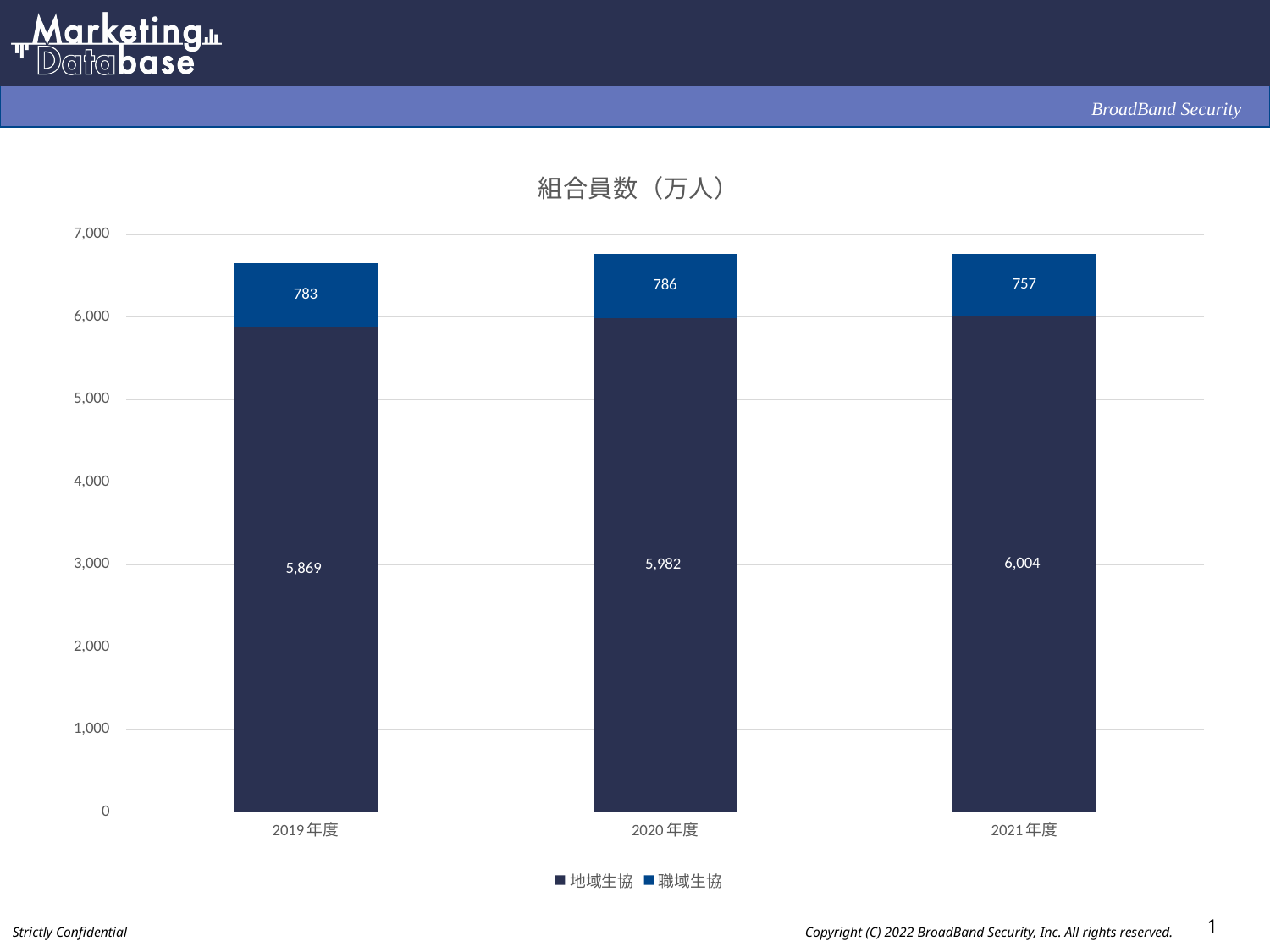
What is the value for 地域生協 in 2019年度? 5,869 How many years are shown on the x axis? 3 How many series does the legend list? 2 What is the difference between the 地域生協 values for 2021年度 and 2019年度? 135 What kind of chart is shown on the slide? Stacked bar chart What is the value for 地域生協 in 2020年度? 5,982 Which year has the lowest value for 職域生協? 2021年度 Which year has the highest value for 地域生協? 2021年度 What is the total of the stacked bar for 2020年度? 6,768 What is the value for 職域生協 in 2021年度? 757 What is the title of the chart? 組合員数（万人） Which is larger, the 職域生協 value for 2019年度 or for 2020年度? 2020年度